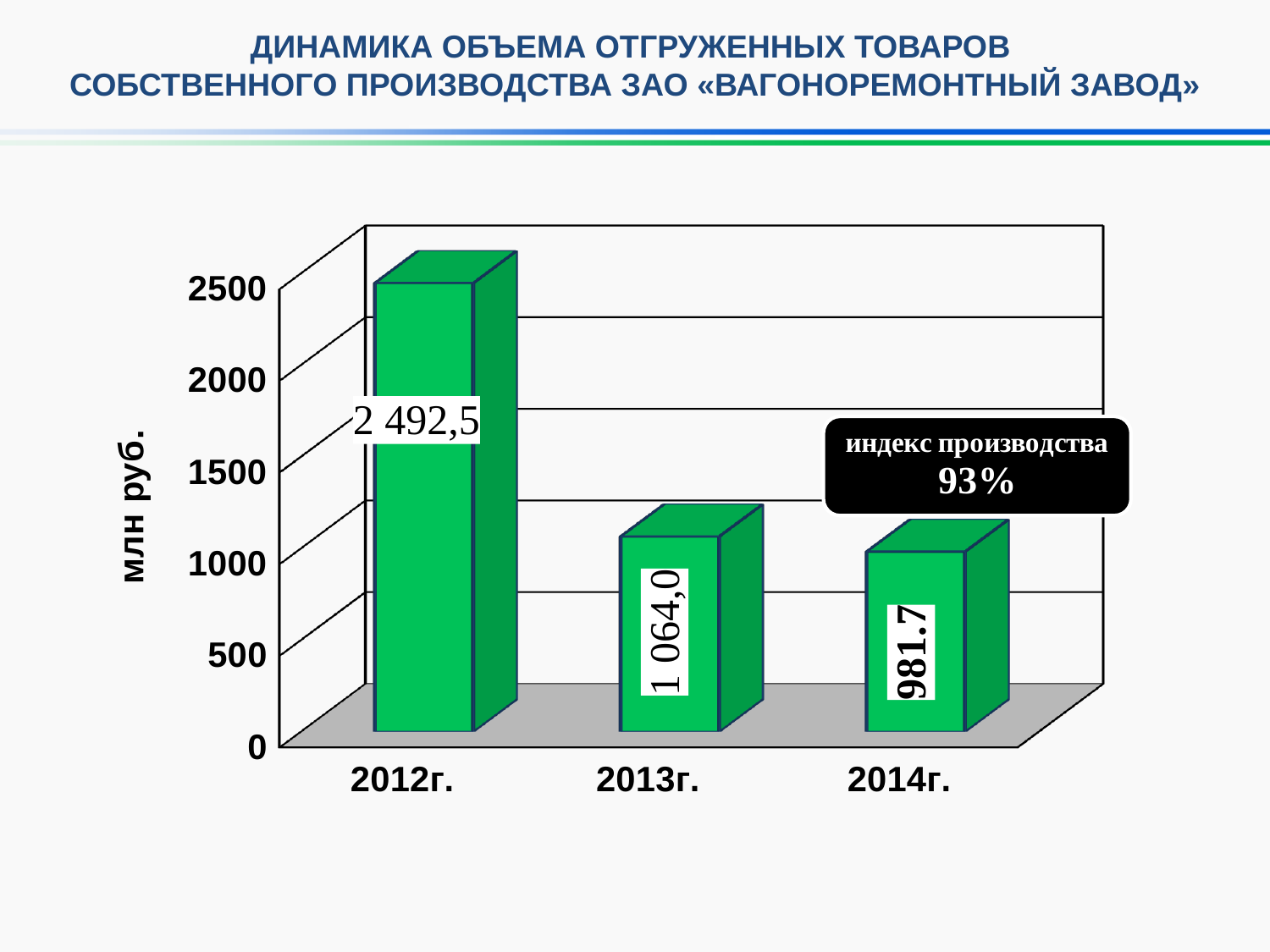
What kind of chart is shown? bar chart Do the values rise or fall from 2012г. to 2014г.? fall Which is larger, the value for 2013г. or the value for 2014г.? 2013г. Is the value for 2014г. greater or less than 1000? less How many years are shown on the x axis? 3 Which year has the lowest value? 2014г. Which year has the highest value? 2012г. What is the value for 2012г.? 2 492,5 What is the difference between the values for 2012г. and 2013г.? 1 428,5 What is the value for 2014г.? 981.7 What is the value for 2013г.? 1 064,0 What is the difference between the values for 2013г. and 2014г.? 82,3